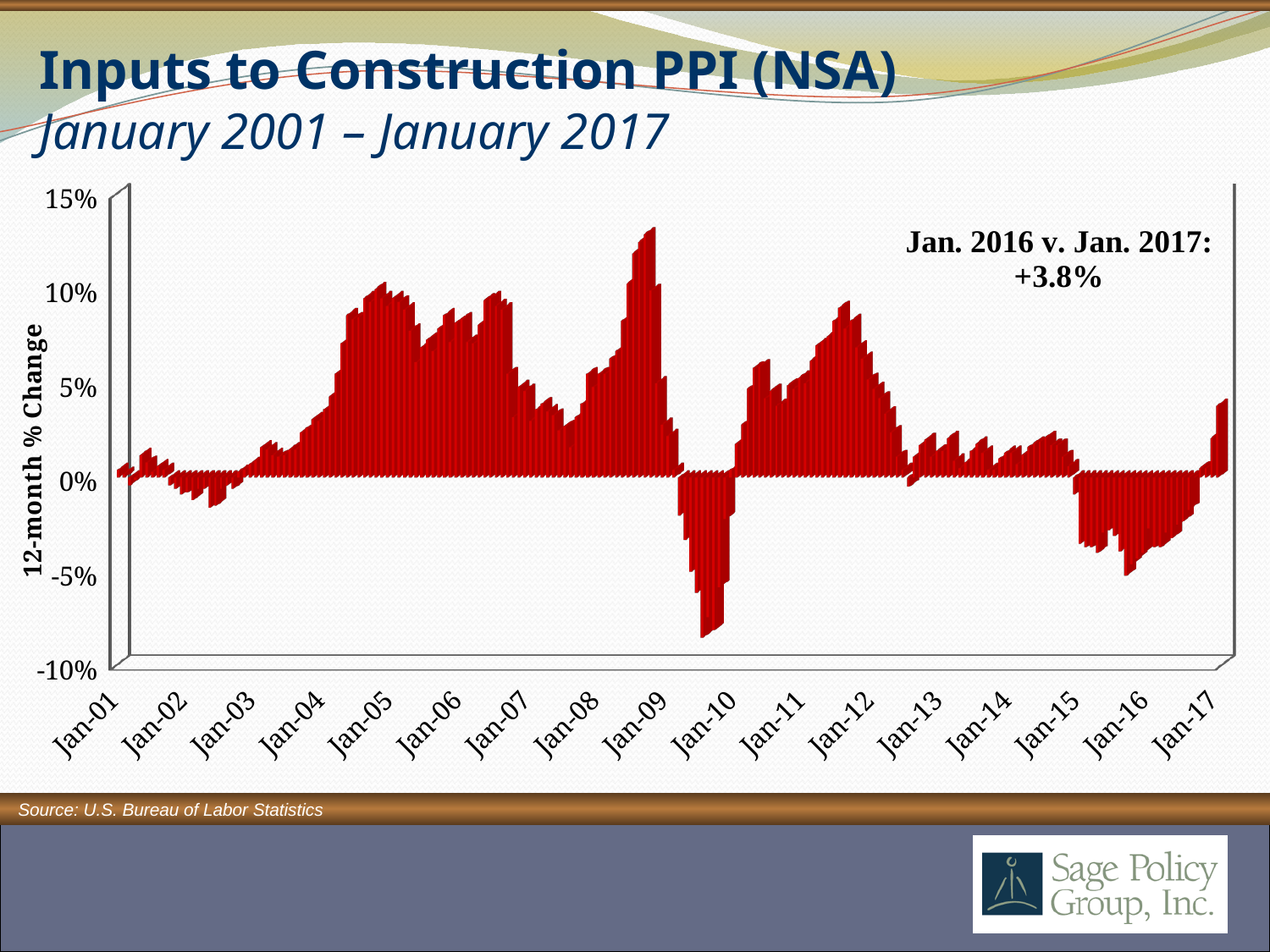
What kind of chart is shown on the slide? Bar chart Do the values rise or fall from Jan-16 to Jan-17? Rise Is the lowest bar on the chart (in late 2009) greater or less than -5%? less How many year labels are shown on the x axis? 17 What is the title of the vertical axis? 12-month % Change Is the highest bar on the chart (around mid-2008) greater or less than 10%? greater Is the value for Jan-04 greater or less than 5%? less What is the 12-month % change from Jan. 2016 to Jan. 2017 stated on the chart? +3.8% Between which two x-axis labels does the chart reach its highest value? Between Jan-08 and Jan-09